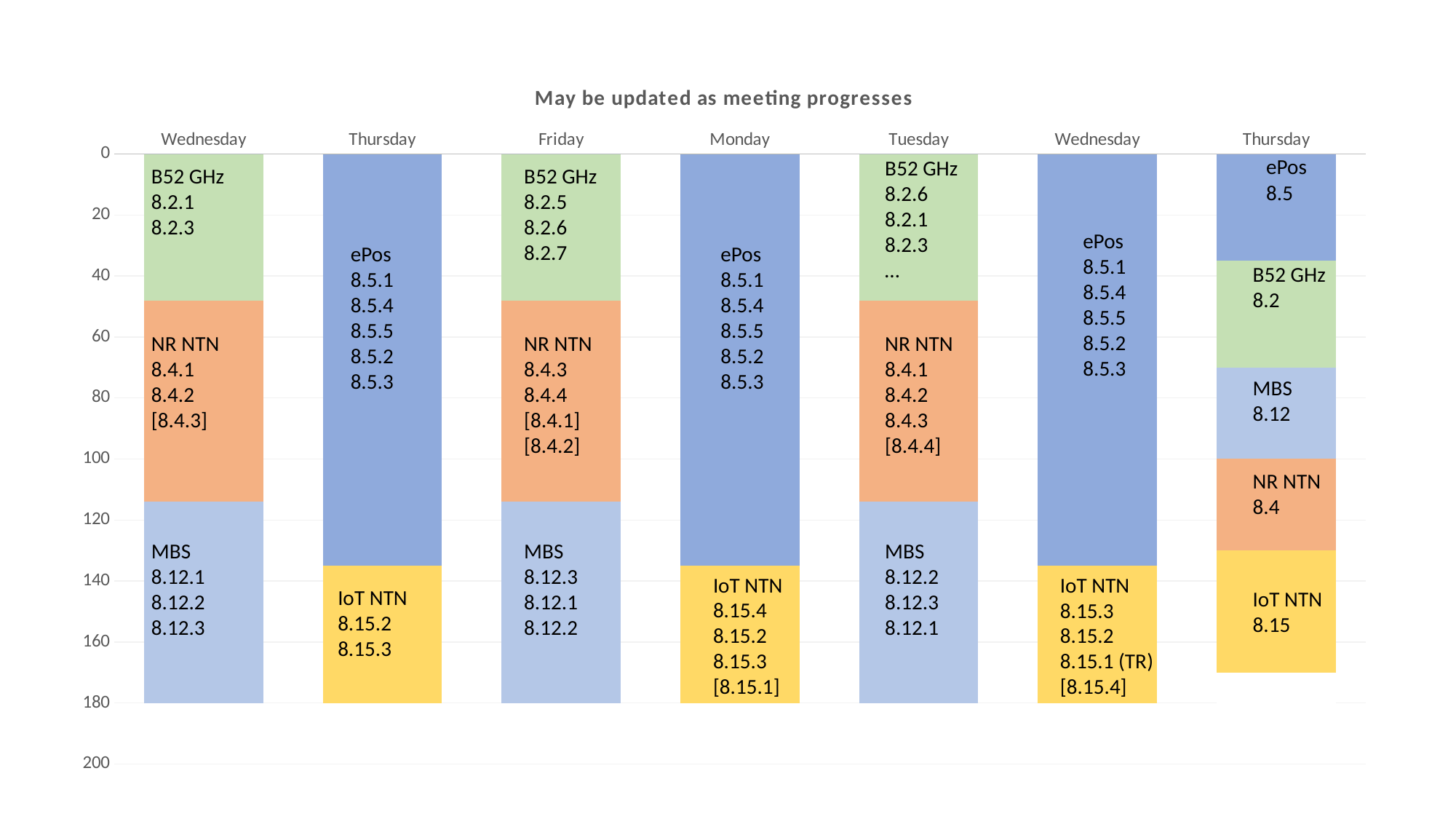
Is the total length of the first Wednesday bar greater or less than 100? greater How many segments does the last Thursday bar contain? 5 What kind of chart is shown on the slide? Stacked bar chart In the first Thursday bar, does the ePos segment end at a value greater or less than 120? greater Which topic is shown in the yellow segments? IoT NTN How many day columns (bars) does the chart show? 7 Which topic occupies the top segment of the first Wednesday bar? B52 GHz Which agenda items are listed under IoT NTN in the first Thursday bar? 8.15.2, 8.15.3 What is the title of the chart? May be updated as meeting progresses Which agenda item is listed under NR NTN in the last Thursday bar? 8.4 Which day's bar is the shortest? Thursday (last bar) Which agenda items are listed under ePos in the Monday bar? 8.5.1, 8.5.4, 8.5.5, 8.5.2, 8.5.3